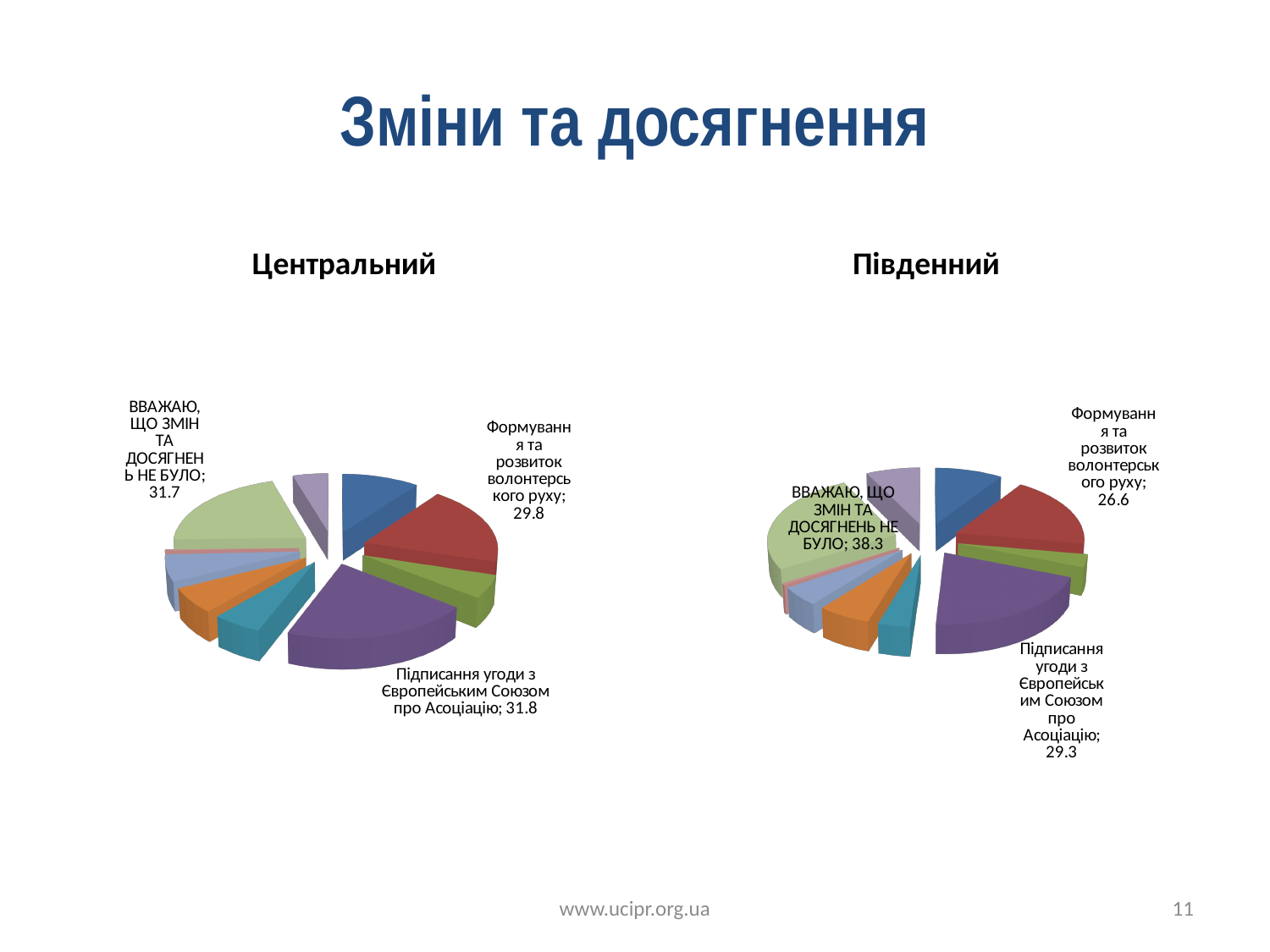
In the Південний chart, what value is shown for "ВВАЖАЮ, ЩО ЗМІН ТА ДОСЯГНЕНЬ НЕ БУЛО"? 38.3 What type of chart is used for the Центральний data? Pie chart What is the title of the slide? Зміни та досягнення Which chart shows a larger value for "ВВАЖАЮ, ЩО ЗМІН ТА ДОСЯГНЕНЬ НЕ БУЛО", Центральний or Південний? Південний In the Центральний chart, what value is shown for "Формування та розвиток волонтерського руху"? 29.8 In the Південний chart, which of the labelled categories has the largest value? ВВАЖАЮ, ЩО ЗМІН ТА ДОСЯГНЕНЬ НЕ БУЛО In the Південний chart, what value is shown for "Формування та розвиток волонтерського руху"? 26.6 In the Центральний chart, what value is shown for "Підписання угоди з Європейським Союзом про Асоціацію"? 31.8 In the Центральний chart, what is the difference between the values for "Підписання угоди з Європейським Союзом про Асоціацію" and "Формування та розвиток волонтерського руху"? 2.0 In the Південний chart, what is the difference between the values for "ВВАЖАЮ, ЩО ЗМІН ТА ДОСЯГНЕНЬ НЕ БУЛО" and "Формування та розвиток волонтерського руху"? 11.7 In the Центральний chart, what value is shown for "ВВАЖАЮ, ЩО ЗМІН ТА ДОСЯГНЕНЬ НЕ БУЛО"? 31.7 In the Південний chart, what value is shown for "Підписання угоди з Європейським Союзом про Асоціацію"? 29.3